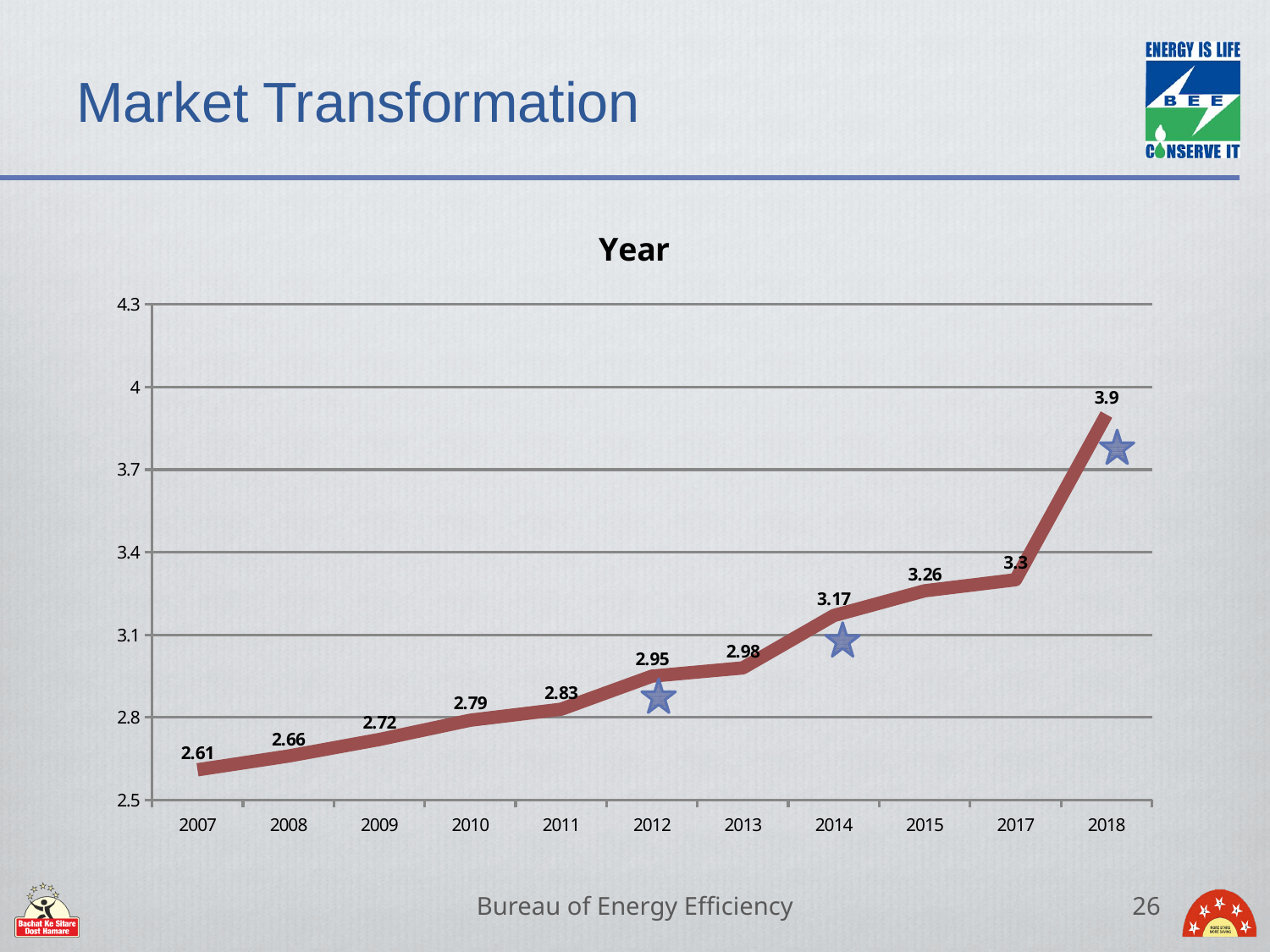
What kind of chart is shown on the slide? line chart Which year has the highest value? 2018 What is the difference between the values for 2018 and 2017? 0.6 What is the difference between the values for 2013 and 2007? 0.37 What is the value for 2018? 3.9 What is the value for 2012? 2.95 Which is larger, the value for 2015 or the value for 2011? 2015 Which year has the lowest value? 2007 Do the values rise or fall from 2007 to 2018? rise What is the value for 2014? 3.17 How many years are plotted on the x axis? 11 What is the value for 2007? 2.61